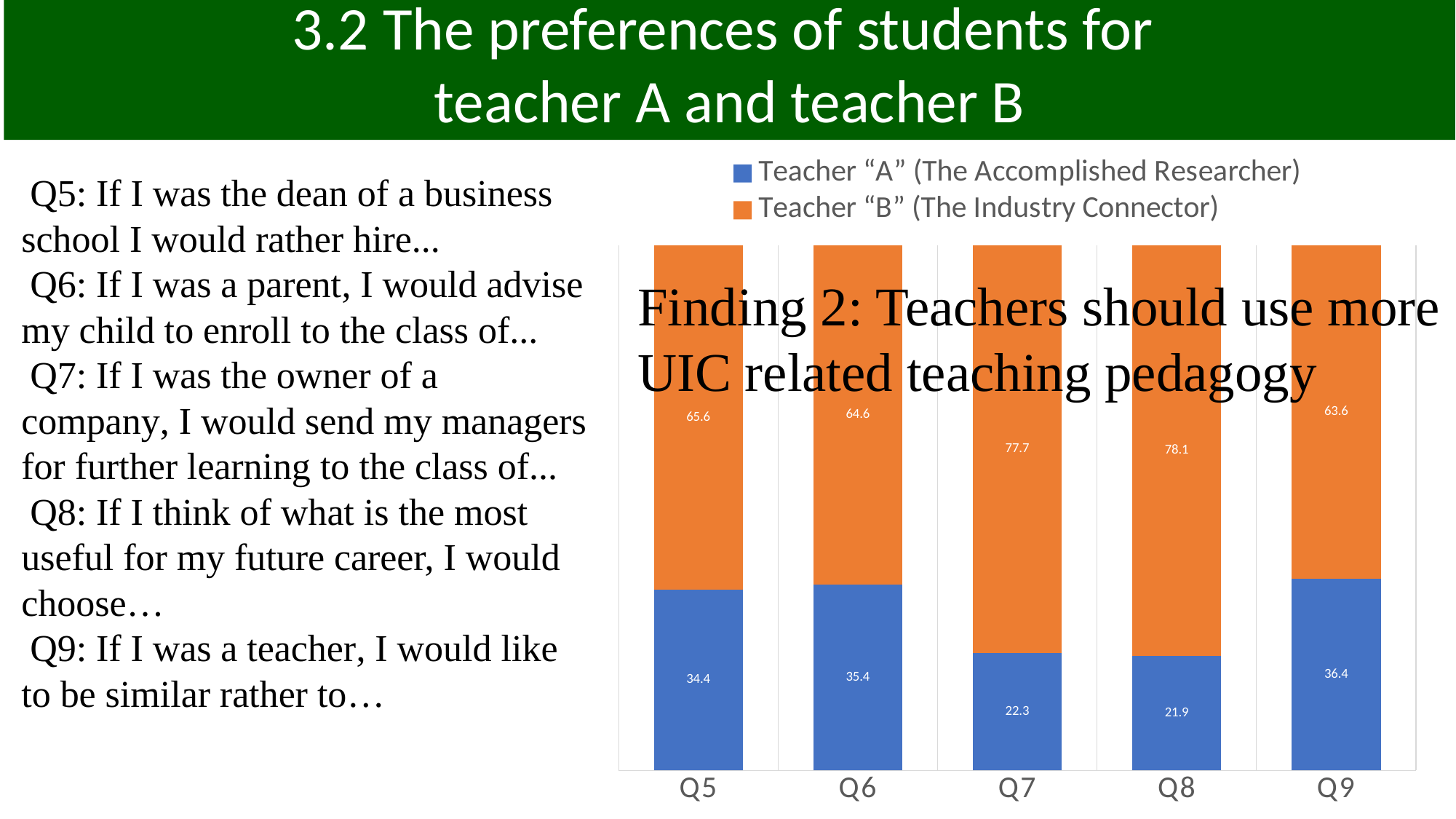
How many categories are shown on the x axis of the chart? 5 What is the value for Teacher "B" (The Industry Connector) at Q7? 77.7 Which colour represents Teacher "B" (The Industry Connector) in the chart? Orange What is the difference between the Teacher "B" and Teacher "A" values at Q8? 56.2 What is the total of the stacked bar for Q5? 100 For which question is the value for Teacher "B" (The Industry Connector) lowest? Q9 What kind of chart is shown on the slide? Stacked bar chart For which question is the value for Teacher "A" (The Accomplished Researcher) highest? Q9 Which is larger at Q6: the value for Teacher "A" or the value for Teacher "B"? Teacher "B" What is the value for Teacher "A" (The Accomplished Researcher) at Q5? 34.4 How many series does the chart legend list? 2 What is the value for Teacher "A" (The Accomplished Researcher) at Q9? 36.4